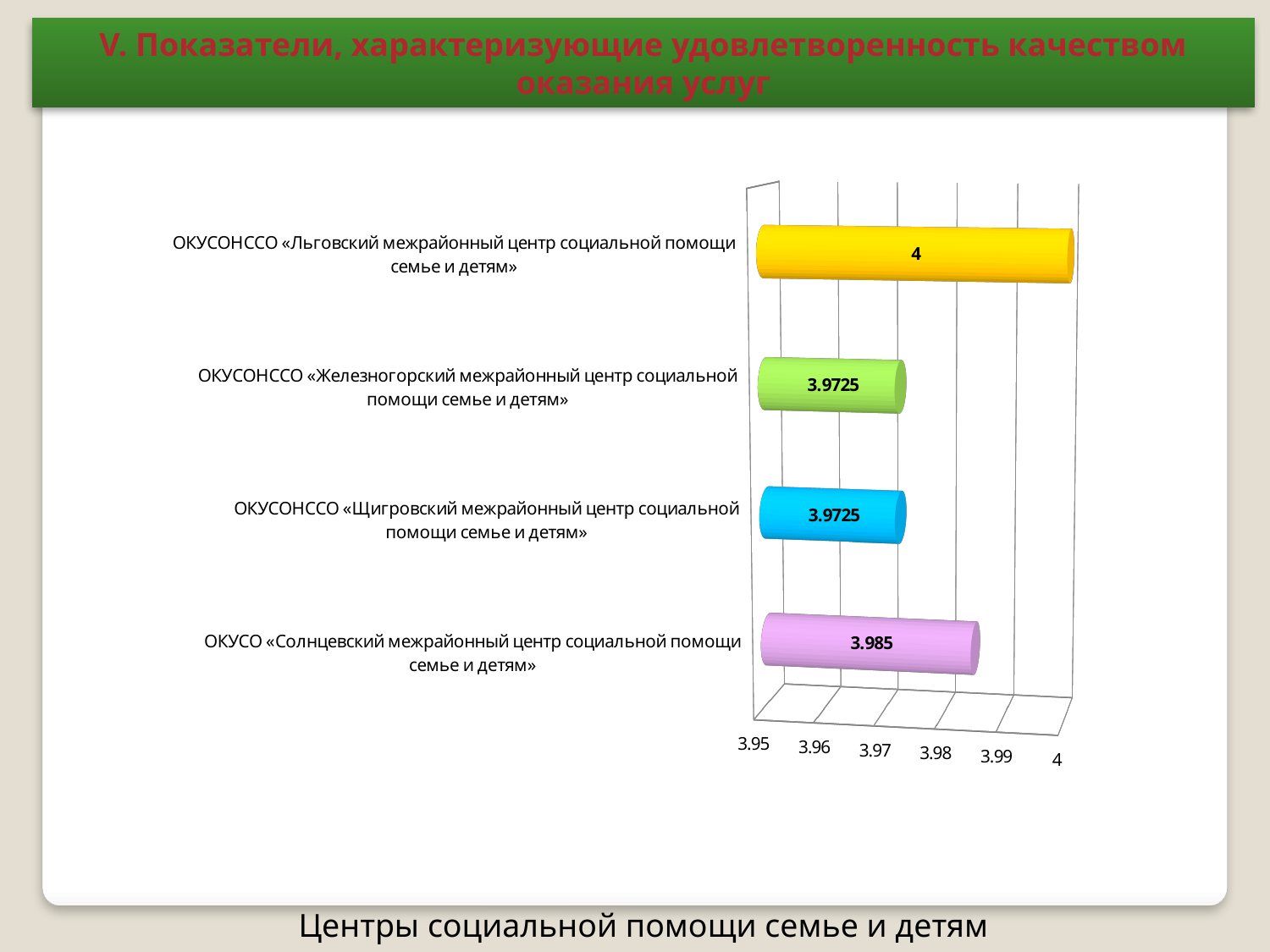
What is the difference between the values for the Солнцевский centre and the Щигровский centre? 0.0125 What is the value for ОКУСОНССО «Железногорский межрайонный центр социальной помощи семье и детям»? 3.9725 What is the value for ОКУСОНССО «Льговский межрайонный центр социальной помощи семье и детям»? 4 What kind of chart is shown on the slide? bar chart Is the value for the Щигровский centre greater or less than 3.98? less What colour is the bar for the Льговский centre? yellow What is the value for ОКУСО «Солнцевский межрайонный центр социальной помощи семье и детям»? 3.985 Which centre has the highest value on the chart? ОКУСОНССО «Льговский межрайонный центр социальной помощи семье и детям» What is the lowest value shown on the horizontal axis? 3.95 What is the difference between the values for the Льговский centre and the Солнцевский centre? 0.015 How many centres are shown on the chart? 4 Which has a larger value, the Солнцевский centre or the Железногорский centre? ОКУСО «Солнцевский межрайонный центр социальной помощи семье и детям»